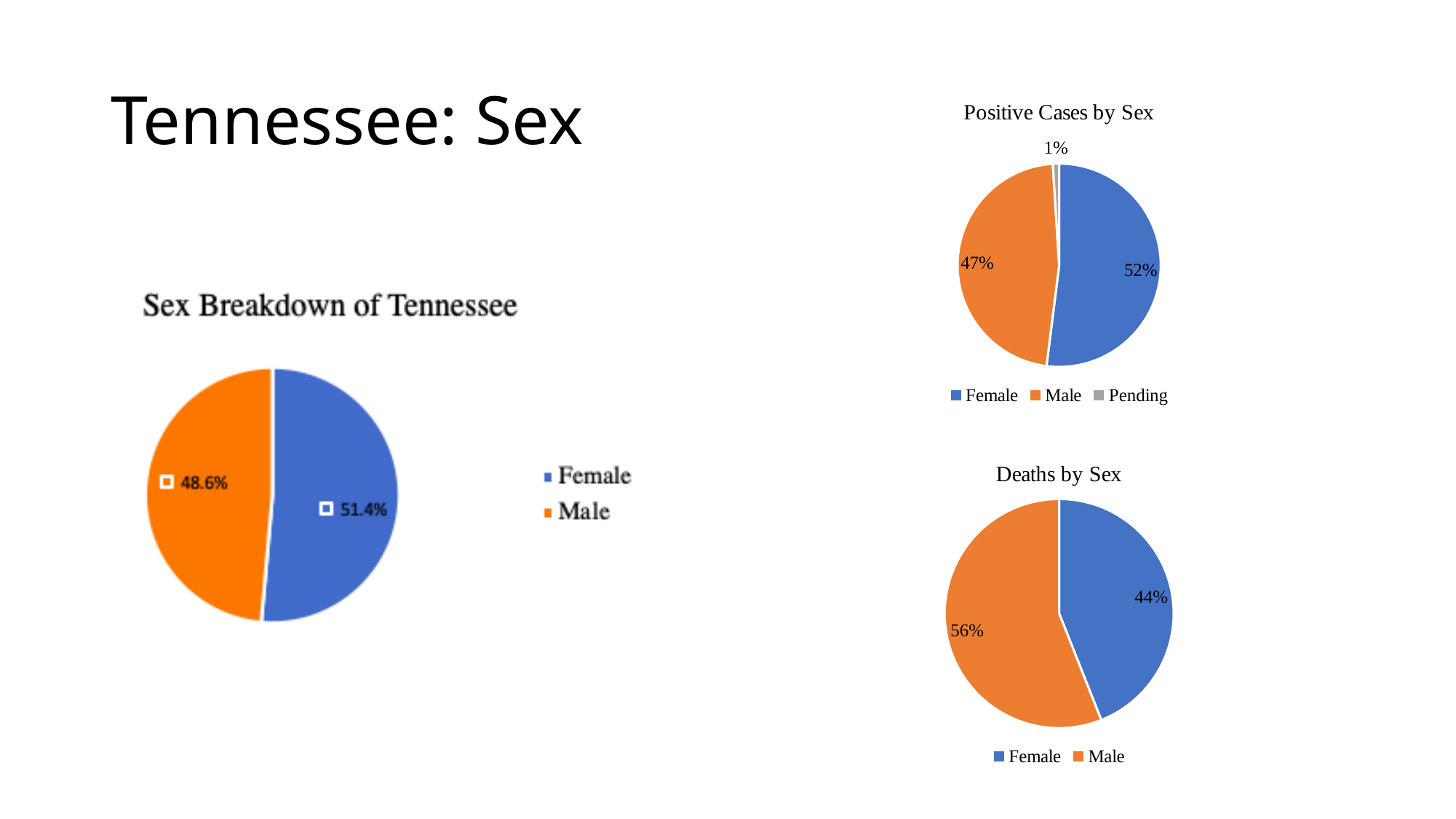
What type of chart is 'Deaths by Sex'? Pie chart In the 'Sex Breakdown of Tennessee' chart, what is the Female share? 51.4% In the 'Deaths by Sex' chart, what is the difference between the Male and Female percentages? 12% In the 'Positive Cases by Sex' chart, what percentage of positive cases are Male? 47% In the 'Positive Cases by Sex' chart, which category has the smallest share? Pending In the 'Deaths by Sex' chart, what percentage of deaths are Female? 44% In the 'Deaths by Sex' chart, what percentage of deaths are Male? 56% How many categories does the legend of the 'Positive Cases by Sex' chart list? 3 In the 'Positive Cases by Sex' chart, what percentage of positive cases are Female? 52% In the 'Sex Breakdown of Tennessee' chart, what is the Male share? 48.6% In the 'Positive Cases by Sex' chart, what percentage of positive cases are Pending? 1% In the 'Deaths by Sex' chart, which category has the largest share? Male